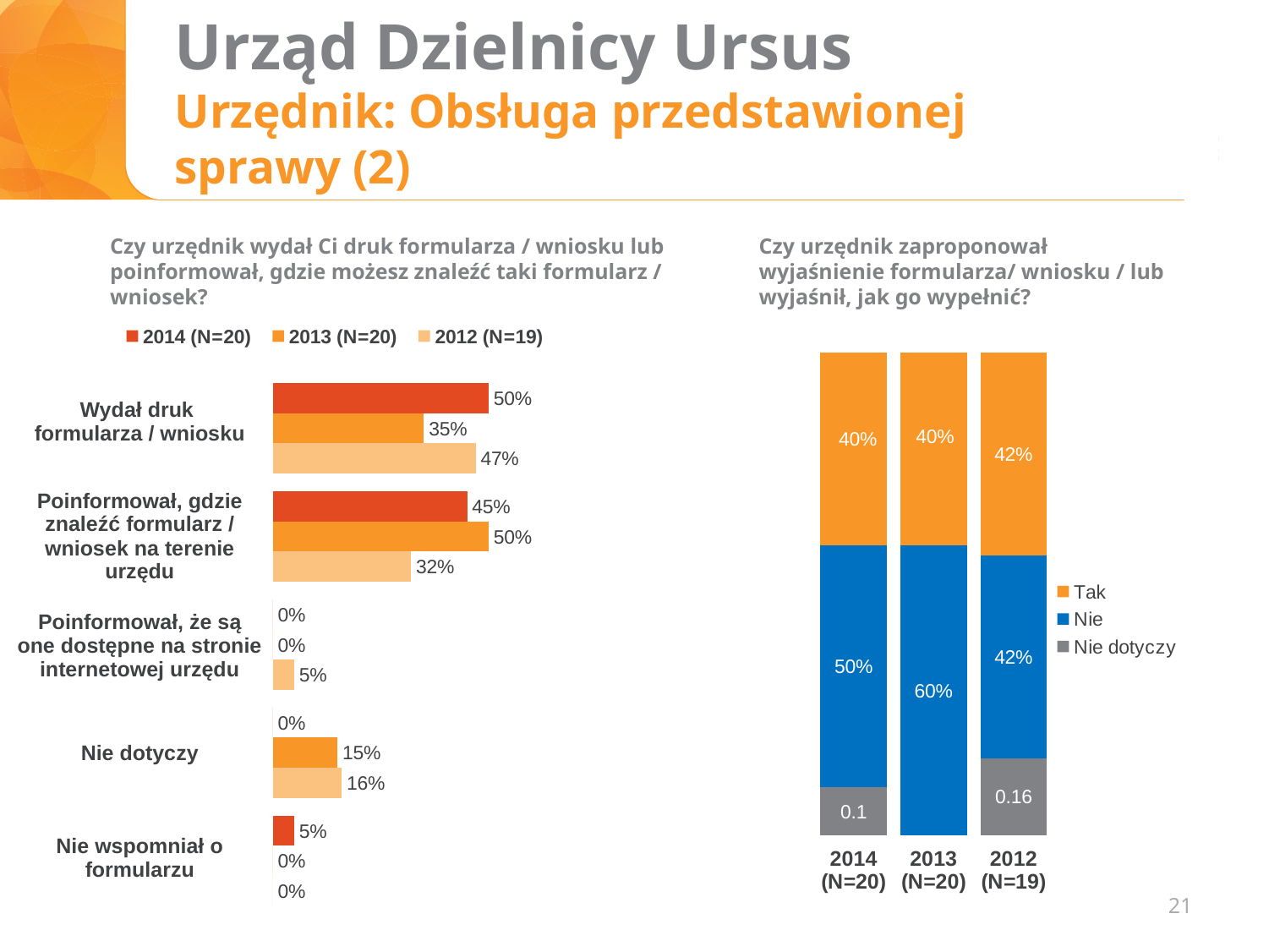
What kind of chart is the chart on the right? Stacked bar chart In the right chart, what is the 'Tak' value for 2012 (N=19)? 42% In the left chart, what is the difference between the 2014 (N=20) and 2013 (N=20) values for 'Wydał druk formularza / wniosku'? 15% In the left chart, how many categories are shown? 5 In the left chart, which is larger for 'Poinformował, gdzie znaleźć formularz / wniosek na terenie urzędu': the 2014 (N=20) value or the 2013 (N=20) value? 2013 (N=20) In the right chart, what is the 'Nie' value for 2013 (N=20)? 60% In the right chart, which year has the highest 'Nie' value? 2013 (N=20) In the right chart, how many series does the legend list? 3 In the left chart, what is the value for 2013 (N=20) for 'Nie dotyczy'? 15% In the left chart, how many series does the legend list? 3 In the left chart, what is the value for 2014 (N=20) for 'Wydał druk formularza / wniosku'? 50% In the left chart, what is the value for 2012 (N=19) for 'Poinformował, gdzie znaleźć formularz / wniosek na terenie urzędu'? 32%